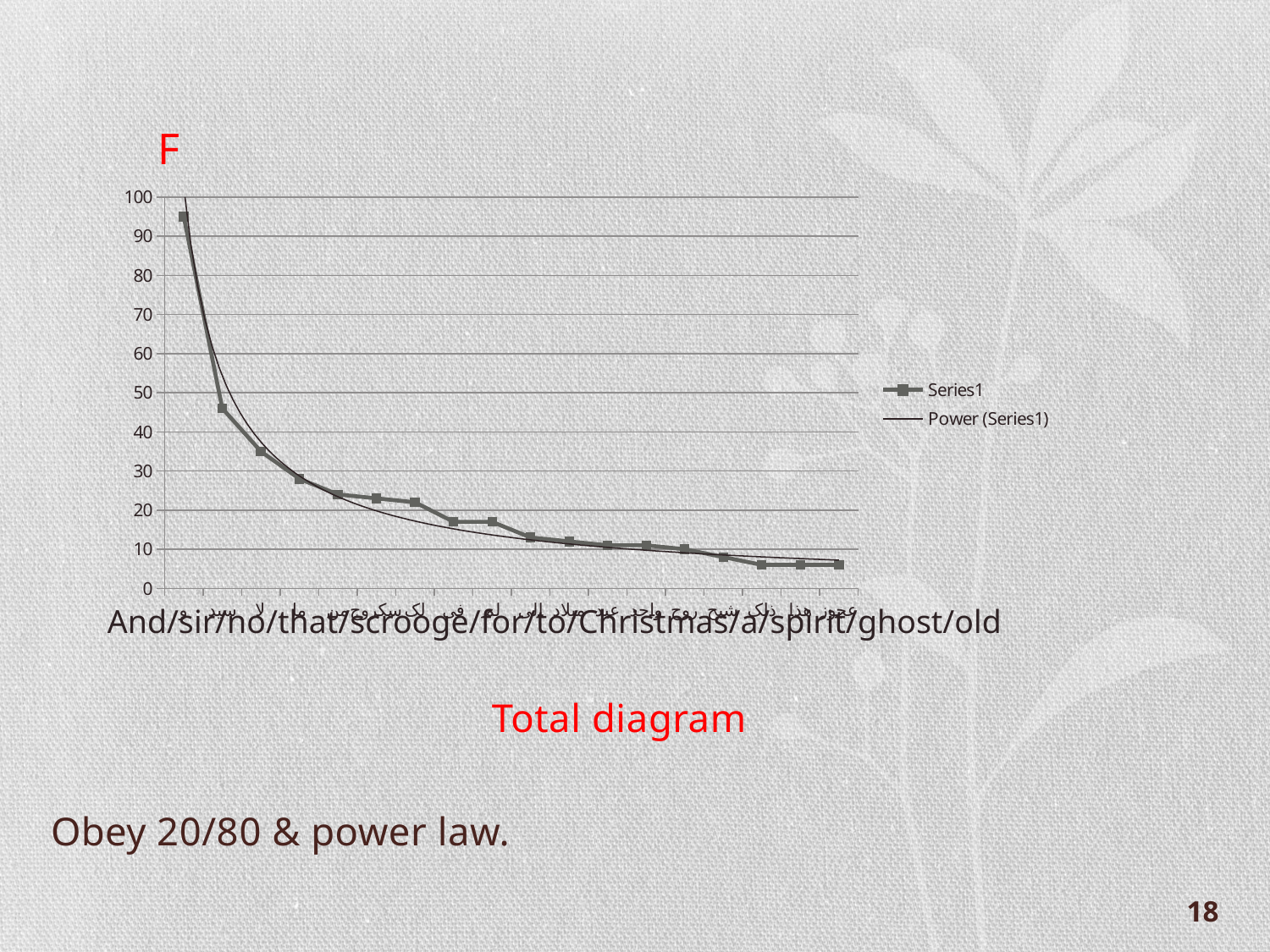
Is the value of the second Series1 point greater or less than 40? greater What are the two entries in the chart legend? Series1 and Power (Series1) What is the title written below the chart? Total diagram What is the maximum value shown on the y axis? 100 Is the value of the second Series1 point greater or less than 50? less How many series does the legend list? 2 Do the Series1 values rise or fall from left to right along the x axis? fall Is the value of the first (leftmost) Series1 point greater or less than 90? greater Which is larger, the first Series1 point or the second Series1 point? the first point What kind of chart is shown on the slide? line chart